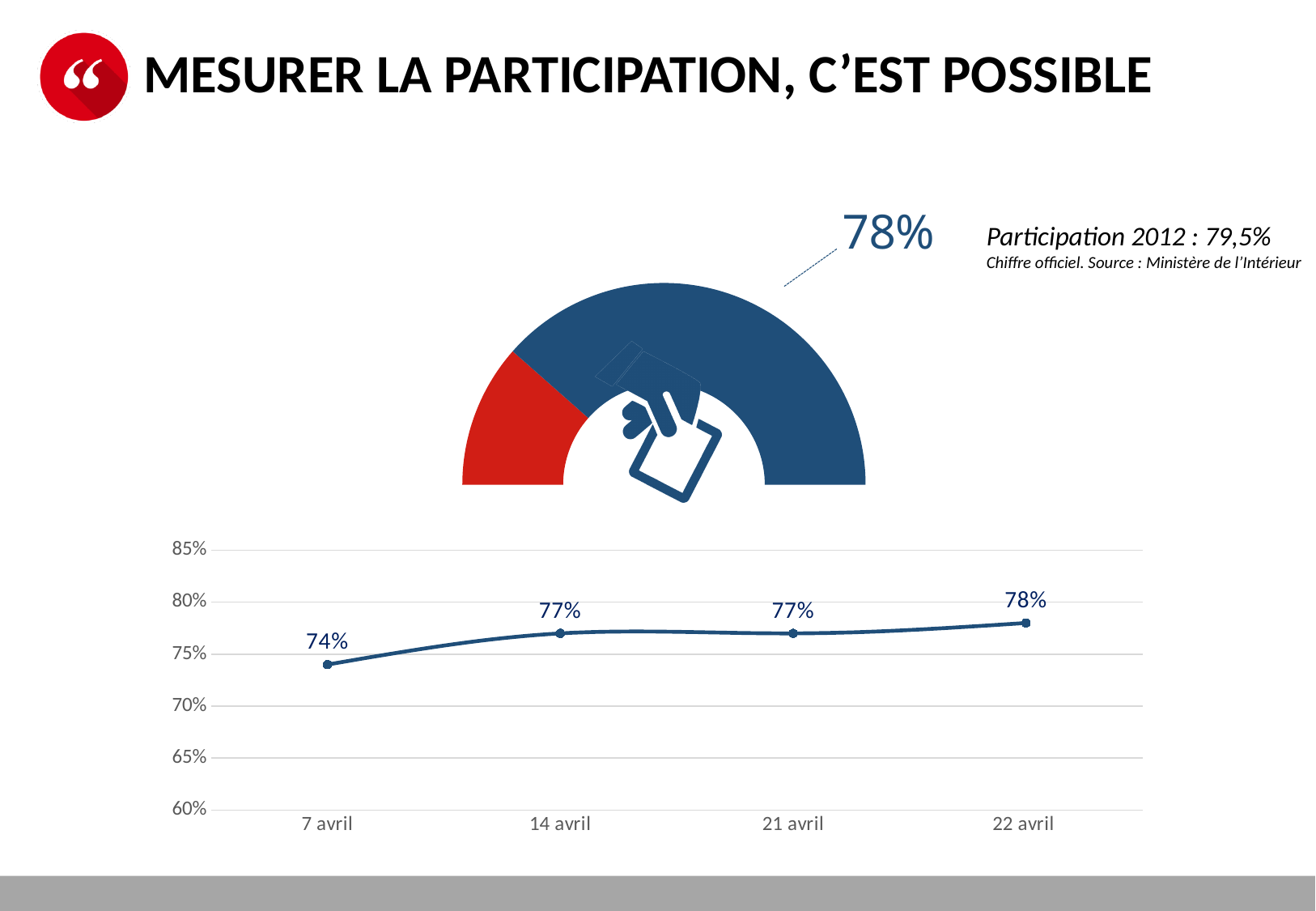
In the line chart at the bottom of the slide, what is the value for 22 avril? 78% In the line chart at the bottom of the slide, what is the value for 14 avril? 77% In the line chart at the bottom of the slide, is the value for 21 avril greater or less than 80%? less How many data points are plotted in the line chart at the bottom of the slide? 4 In the line chart at the bottom of the slide, which is larger, the value for 14 avril or the value for 7 avril? 14 avril In the line chart at the bottom of the slide, what is the difference between the values for 22 avril and 7 avril? 4% What value does the gauge chart at the top of the slide display? 78% In the line chart at the bottom of the slide, which date has the highest value? 22 avril In the line chart at the bottom of the slide, what is the value for 7 avril? 74% In the line chart at the bottom of the slide, which date has the lowest value? 7 avril What kind of chart is shown at the bottom of the slide? line chart In the line chart at the bottom of the slide, do the values generally rise or fall from 7 avril to 22 avril? rise